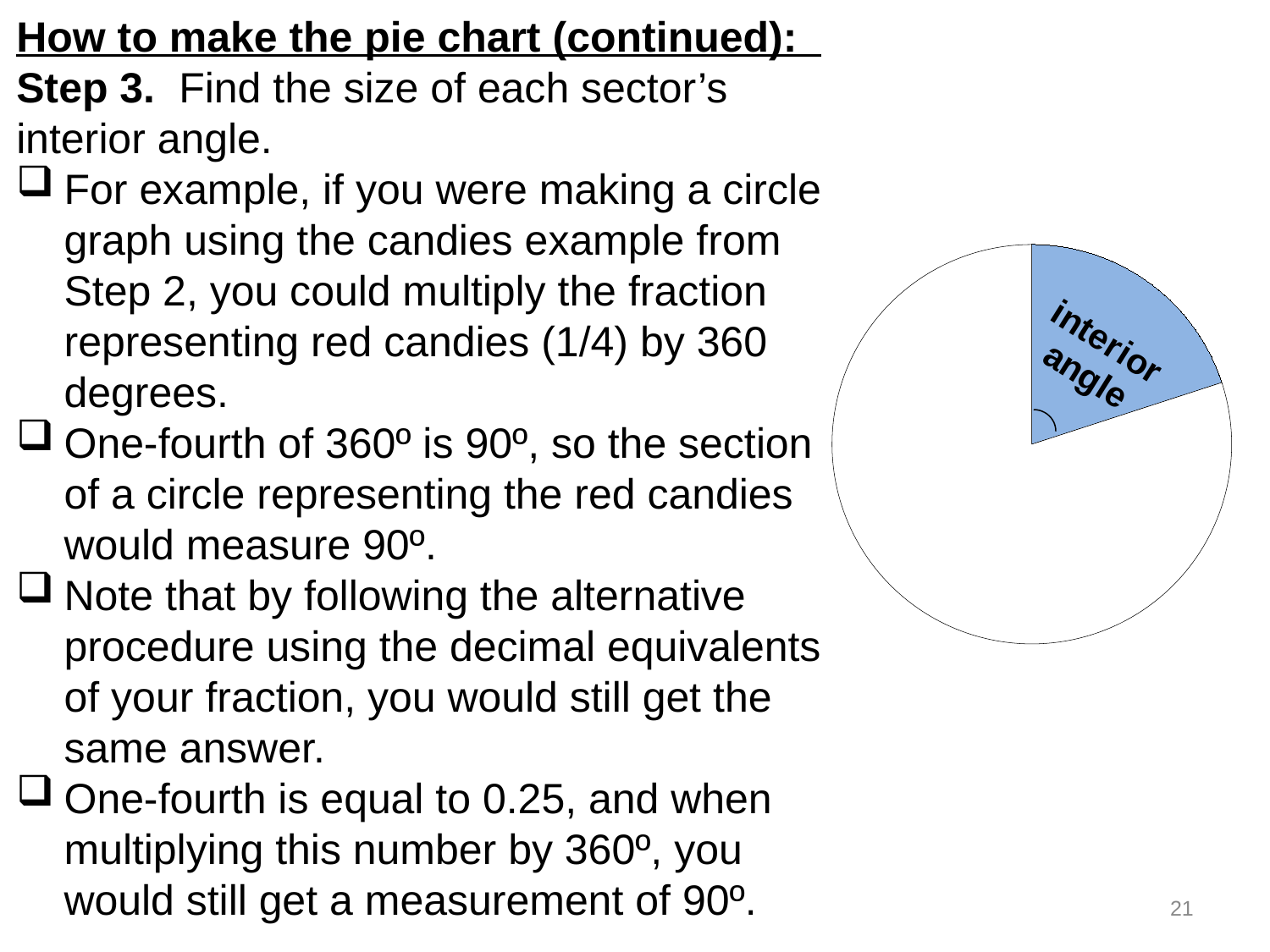
What colour is the shaded sector of the pie chart? blue According to the slide, what fraction of the circle does the sector for red candies represent? 1/4 Is the shaded sector of the pie chart greater or less than half of the circle? less What kind of chart is shown on the right side of the slide? pie chart What label is written inside the shaded sector of the pie chart? interior angle According to the slide, how many degrees is the interior angle of the sector representing red candies? 90º How many shaded sectors does the pie chart have? 1